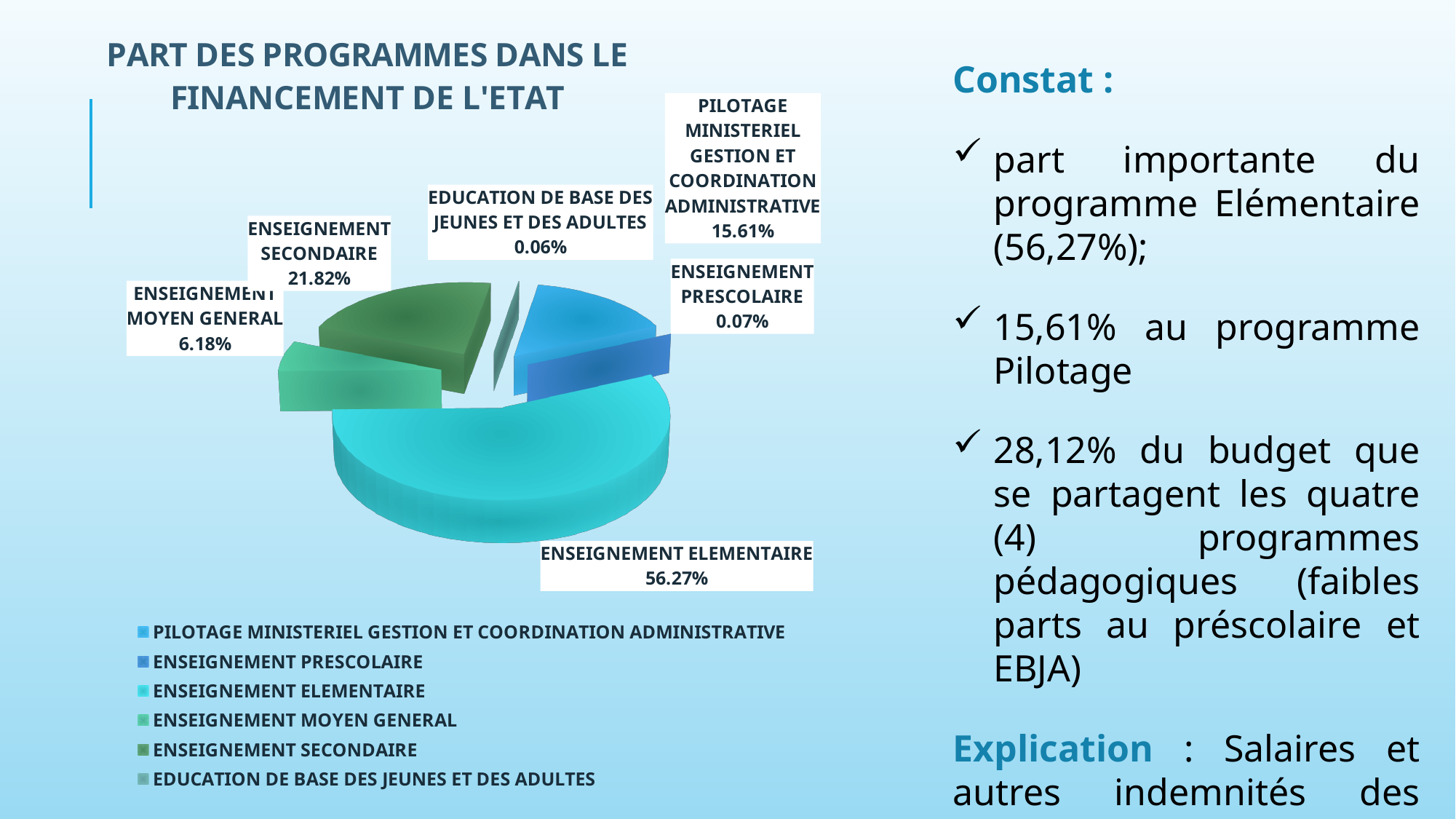
What is the difference in percentage points between ENSEIGNEMENT SECONDAIRE and ENSEIGNEMENT MOYEN GENERAL? 15.64 Which programme has the smallest share of the pie? EDUCATION DE BASE DES JEUNES ET DES ADULTES What is the value shown for ENSEIGNEMENT MOYEN GENERAL? 6.18% How many slices does the pie chart have? 6 What is the value shown for EDUCATION DE BASE DES JEUNES ET DES ADULTES? 0.06% How many entries does the legend list? 6 What type of chart is shown on the slide? Pie chart What is the value shown for PILOTAGE MINISTERIEL GESTION ET COORDINATION ADMINISTRATIVE? 15.61% Which programme has the largest share of the pie? ENSEIGNEMENT ELEMENTAIRE What share of the pie does ENSEIGNEMENT ELEMENTAIRE represent? 56.27% What is the title of the chart? PART DES PROGRAMMES DANS LE FINANCEMENT DE L'ETAT Which is larger, the share for ENSEIGNEMENT SECONDAIRE or the share for PILOTAGE MINISTERIEL GESTION ET COORDINATION ADMINISTRATIVE? ENSEIGNEMENT SECONDAIRE